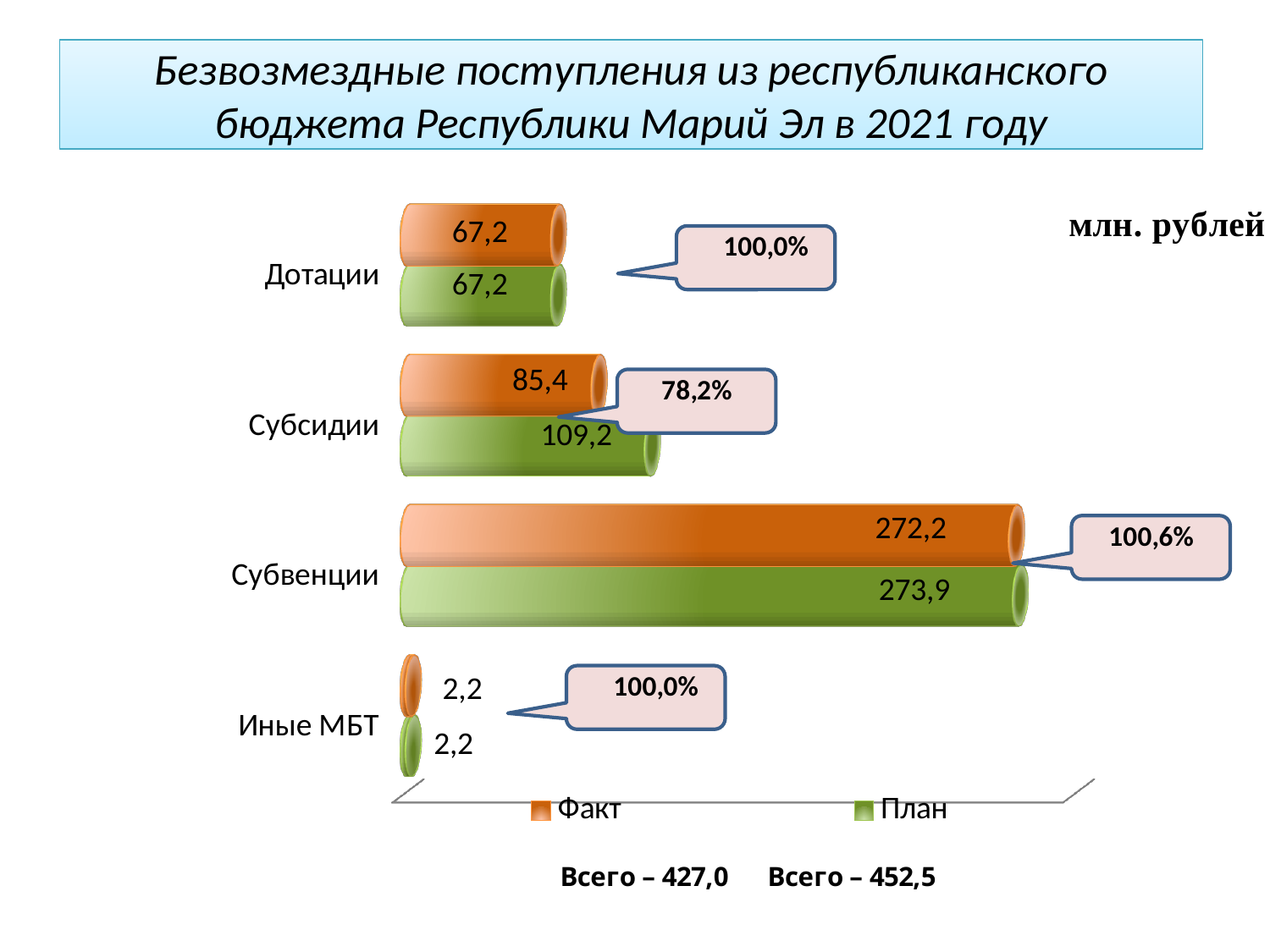
What percentage is shown in the callout next to Субсидии? 78,2% Which category has the lowest План value? Иные МБТ What is the Факт value for Субсидии? 85,4 Which category has the highest Факт value? Субвенции How many series does the legend list? 2 What is the difference between the План and Факт values for Субсидии? 23,8 What is the План value for Дотации? 67,2 How many categories are shown in the chart? 4 Which is larger for Субсидии, the Факт value or the План value? План What is the План value for Субвенции? 273,9 What kind of chart is shown on the slide? Bar chart What is the Факт value for Иные МБТ? 2,2